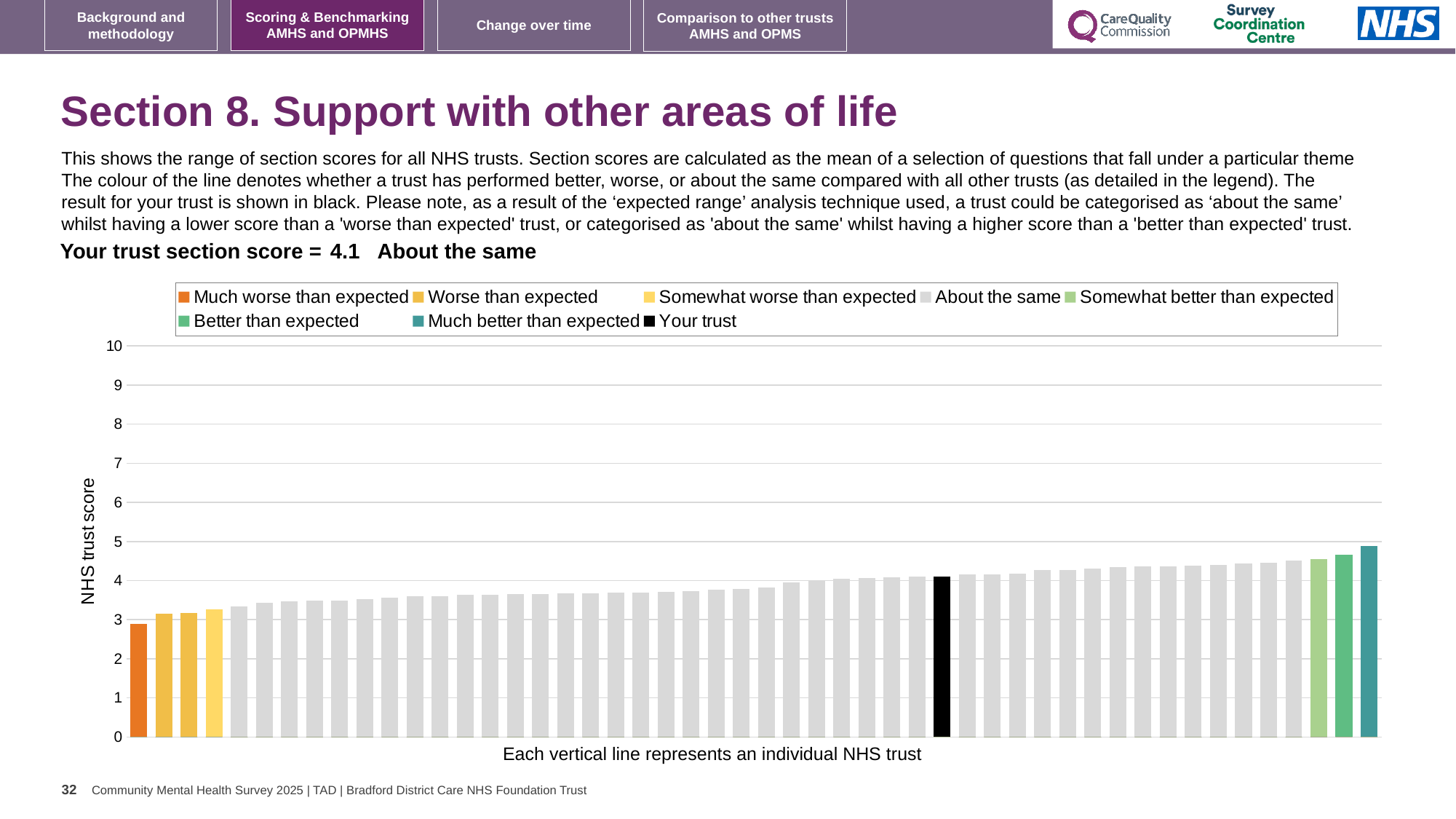
Is the value of the lowest bar greater or less than 2? greater Which category does your trust fall into according to the slide? About the same Is the value of the highest bar greater or less than 4? greater What kind of chart is shown on the slide? Bar chart What is the highest value shown on the y axis? 10 What is the section score for your trust shown on the slide? 4.1 What is the label of the y axis? NHS trust score Is the value for your trust (the black bar) greater or less than 4? greater How many entries does the chart legend list? 8 Do the bar values rise or fall from left to right along the x axis? Rise How many bars are coloured orange (Much worse than expected)? 1